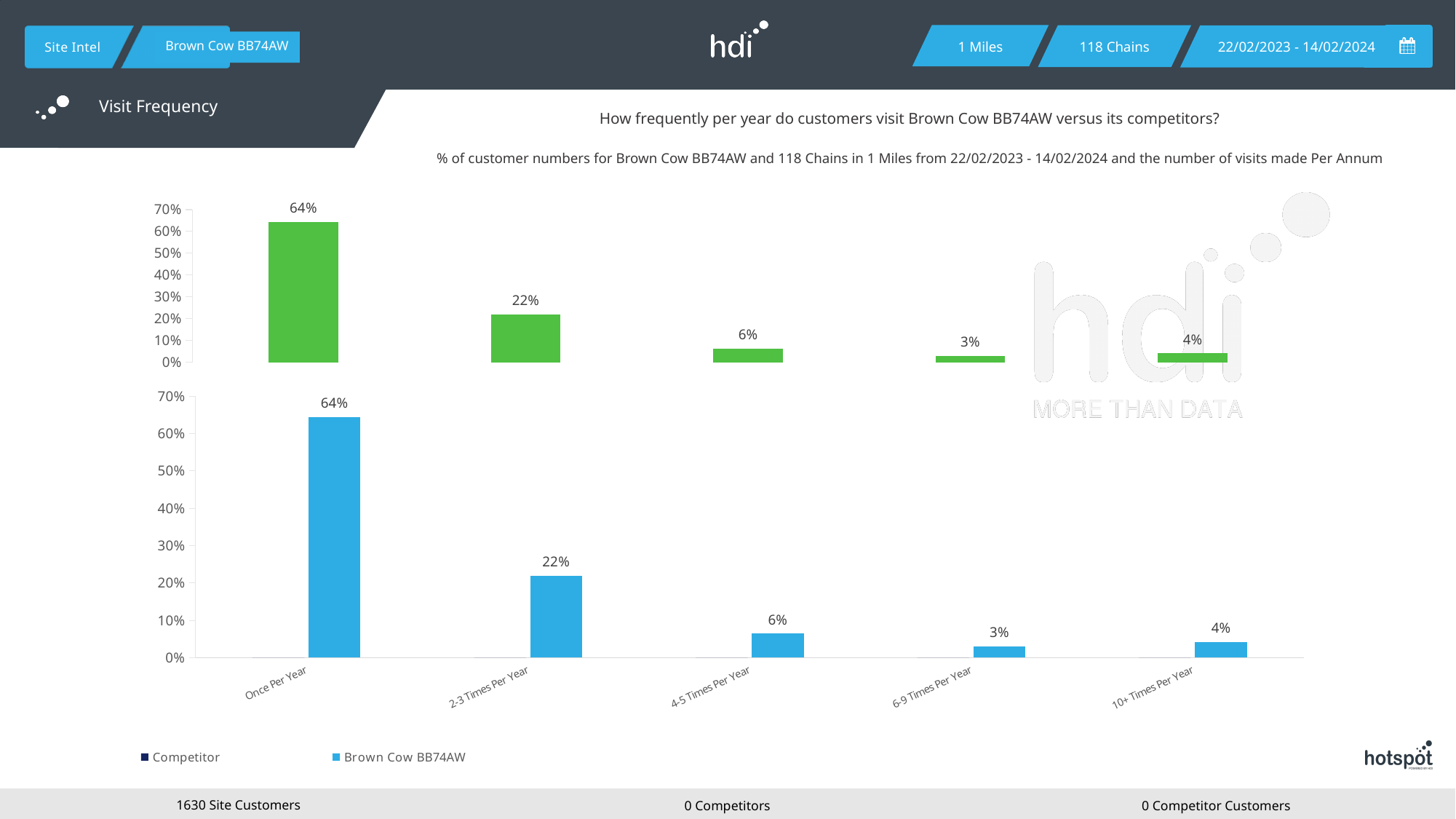
How many series does the legend at the bottom of the slide list? 2 In the bottom chart, which is larger, the value for 6-9 Times Per Year or 10+ Times Per Year? 10+ Times Per Year How many categories are shown on the x axis of the bottom chart? 5 In the bottom chart, which category has the highest value? Once Per Year What kind of chart is the bottom chart? Bar chart In the bottom chart, what is the difference between the values for Once Per Year and 2-3 Times Per Year? 42% In the bottom chart, what is the value for Once Per Year? 64% In the bottom chart, do the values generally rise or fall from Once Per Year to 6-9 Times Per Year? Fall In the bottom chart, what is the value for 10+ Times Per Year? 4% In the bottom chart, what is the value for 2-3 Times Per Year? 22%